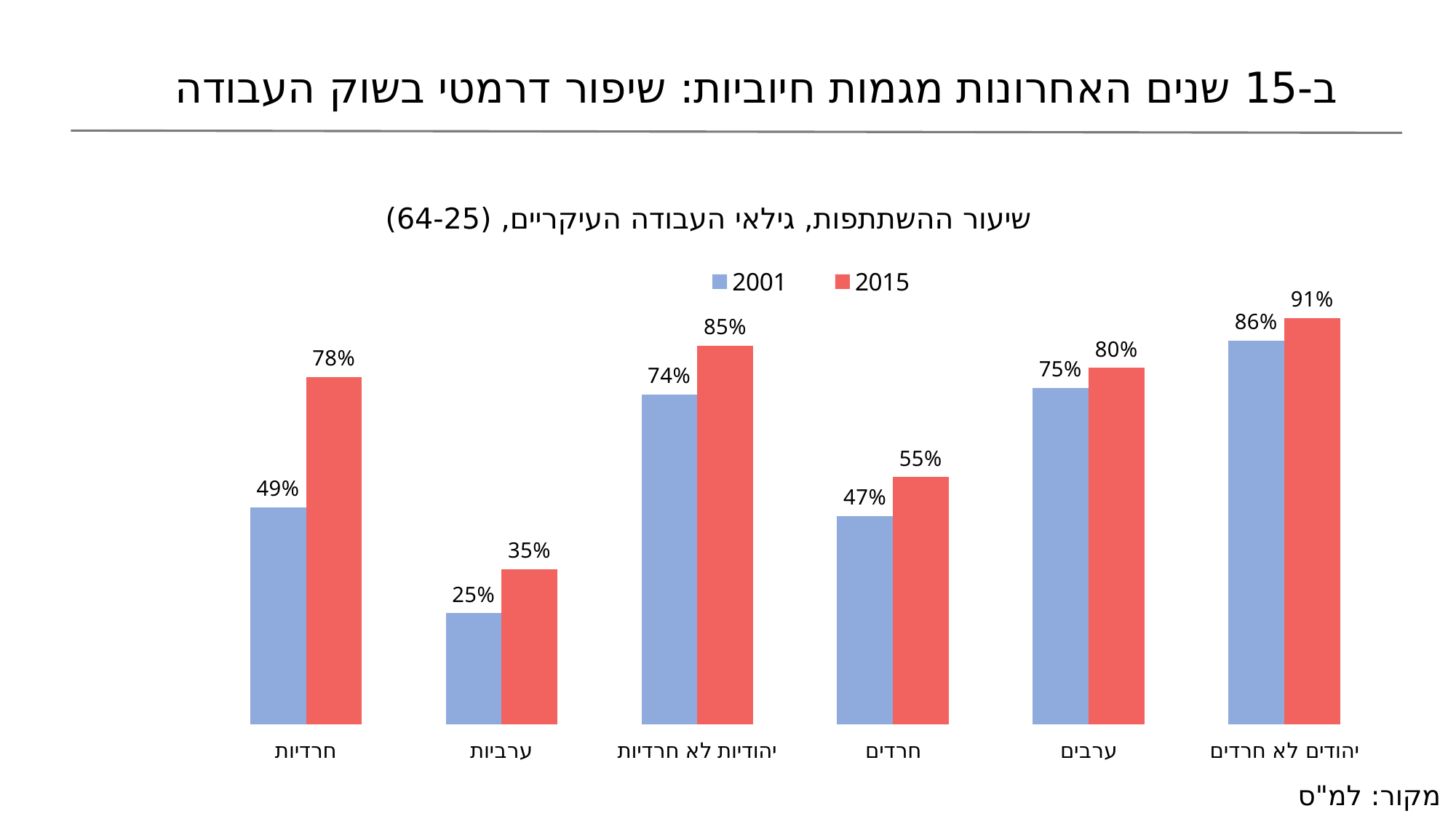
Which is larger, the 2001 value for ערבים or the 2001 value for יהודיות לא חרדיות? ערבים What is the difference between the 2015 and 2001 values for חרדיות? 29% How many series does the legend list? 2 How many categories are shown on the x axis? 6 What is the 2015 value for חרדיות? 78% What is the difference between the 2015 and 2001 values for ערבים? 5% Which category has the highest 2015 value? יהודים לא חרדים What kind of chart is shown on the slide? bar chart What is the 2001 value for יהודיות לא חרדיות? 74% What is the 2015 value for חרדים? 55% What is the 2001 value for ערביות? 25% Which category has the lowest 2001 value? ערביות